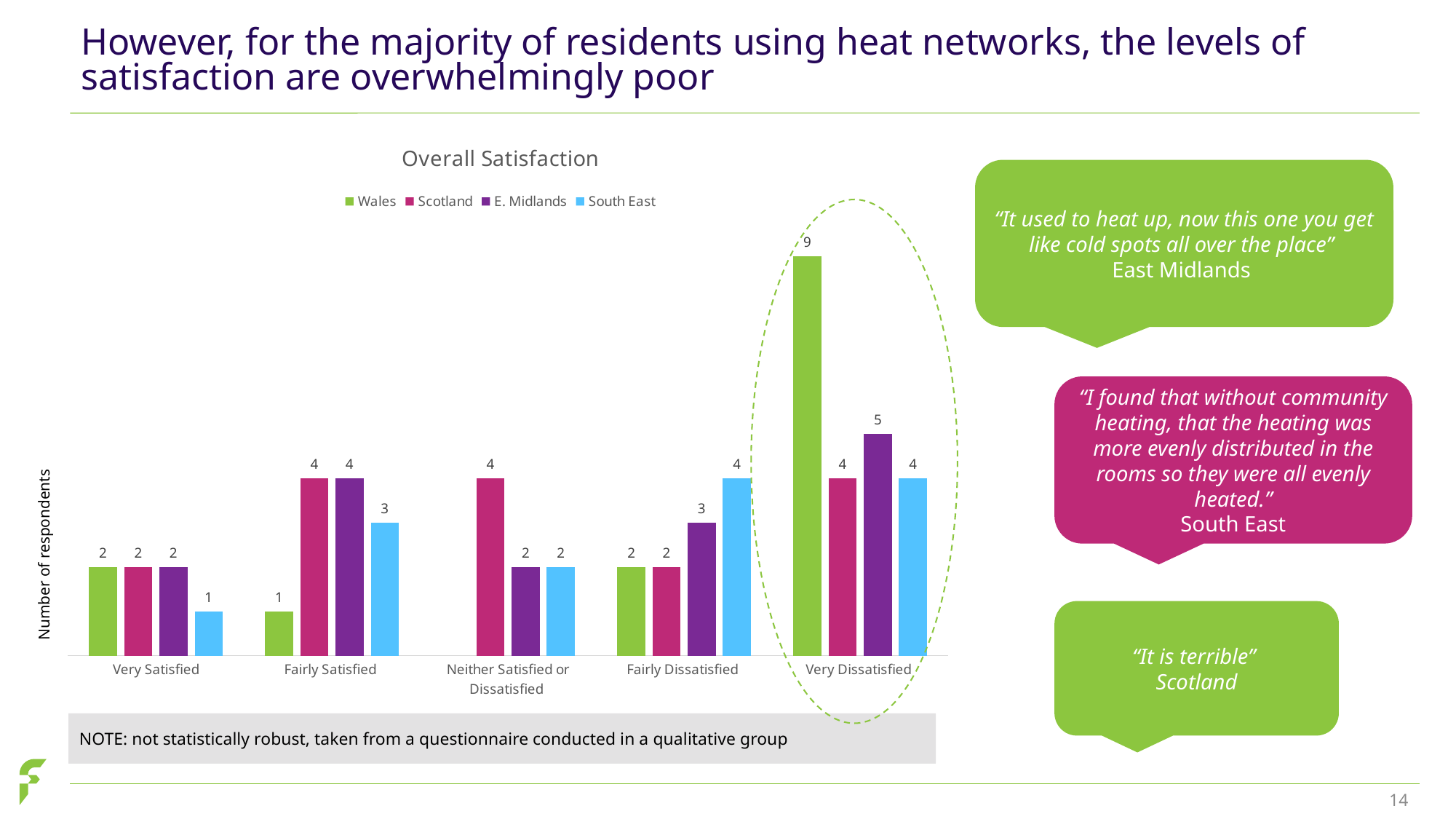
Which region has the lowest value in the Very Satisfied category? South East What is the value for Scotland in the Neither Satisfied or Dissatisfied category? 4 What is the value for South East in the Fairly Dissatisfied category? 4 Which region has the highest value in the Very Dissatisfied category? Wales What kind of chart is shown on the slide? Bar chart What is the value for Wales in the Very Dissatisfied category? 9 How many series does the legend list? 4 What is the title of the chart? Overall Satisfaction How many satisfaction categories are shown on the x axis? 5 What is the value for E. Midlands in the Very Dissatisfied category? 5 In the Fairly Satisfied category, which is larger: the value for Scotland or the value for Wales? Scotland What is the difference between the Wales and Scotland values in the Very Dissatisfied category? 5